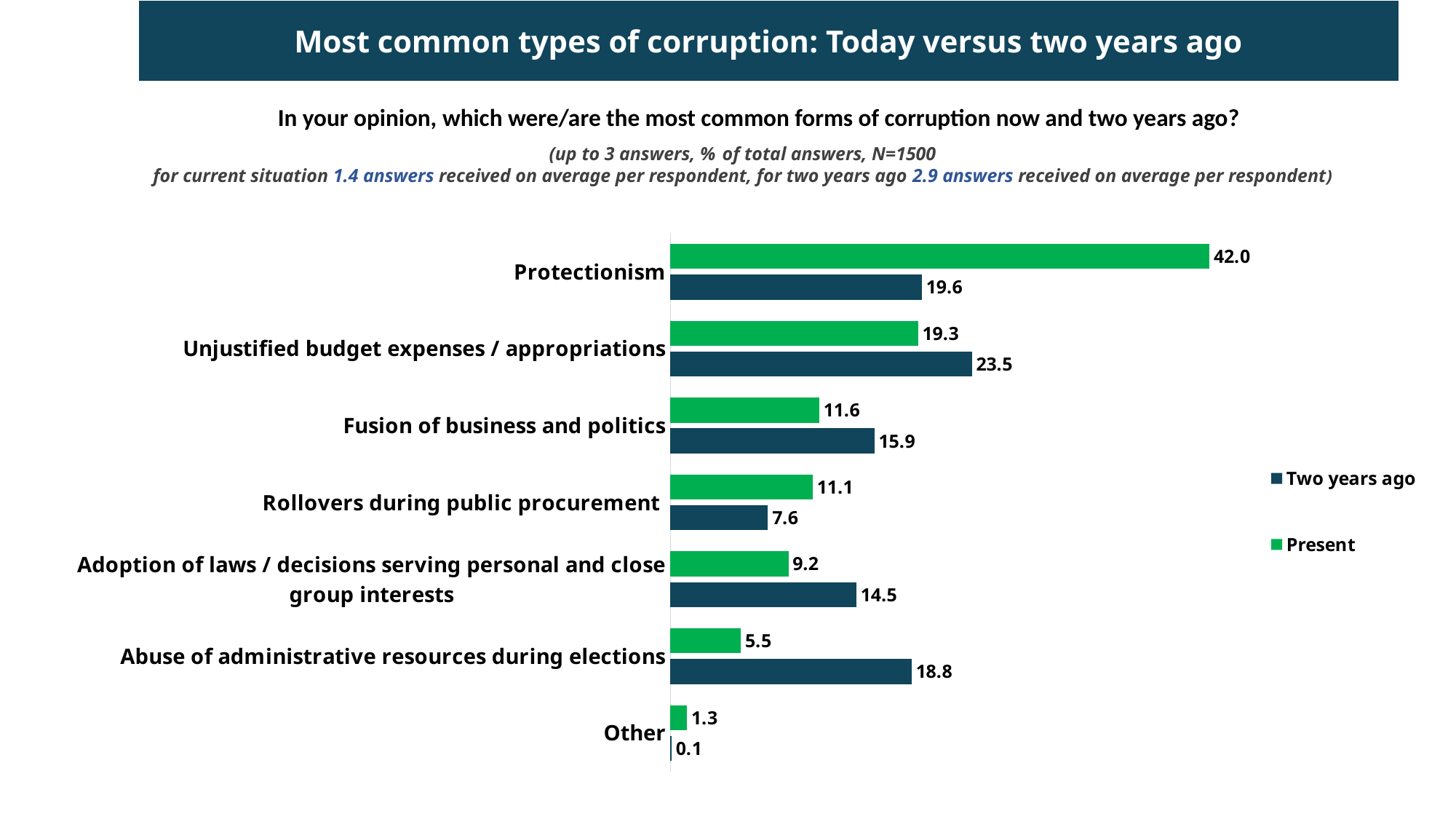
Which category has the lowest Two years ago value? Other What colour are the Present bars? Green Which is larger for Unjustified budget expenses / appropriations: the Present value or the Two years ago value? Two years ago Which category has the highest Two years ago value? Unjustified budget expenses / appropriations How many series does the legend list? 2 What is the difference between the Present and Two years ago values for Protectionism? 22.4 What is the Present value for Rollovers during public procurement? 11.1 Which category has the highest Present value? Protectionism What is the Present value for Protectionism? 42.0 What kind of chart is shown on the slide? Bar chart How many categories are shown on the chart? 7 What is the Two years ago value for Abuse of administrative resources during elections? 18.8